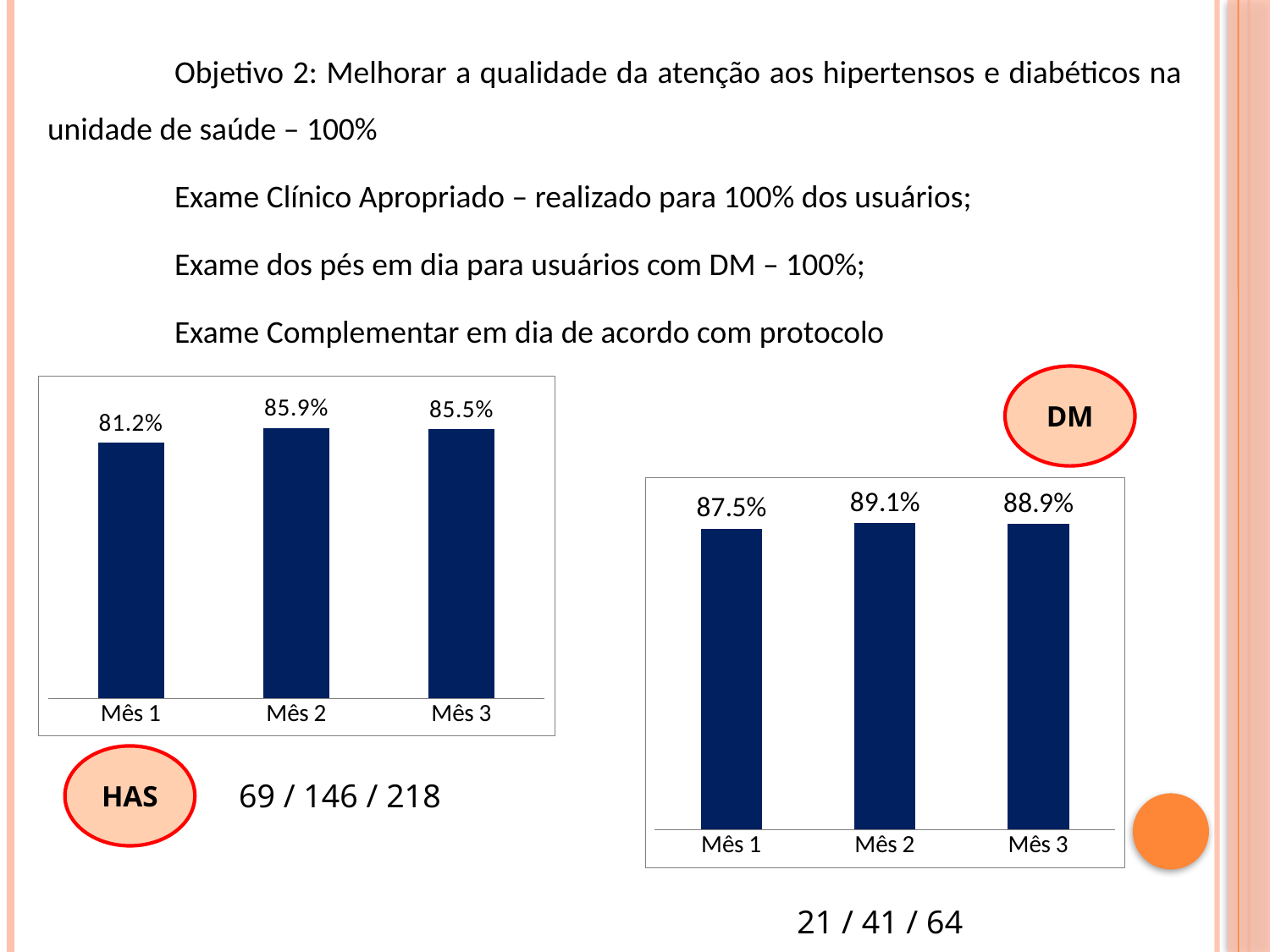
In the left chart (HAS), does the value rise or fall from Mês 1 to Mês 2? Rise In the left chart (HAS), what is the value for Mês 2? 85.9% In the right chart (DM), what is the value for Mês 3? 88.9% How many bars does the left chart (HAS) have? 3 In the left chart (HAS), what is the difference between the values for Mês 2 and Mês 1? 4.7% In the right chart (DM), what is the value for Mês 1? 87.5% In the left chart (HAS), what is the value for Mês 1? 81.2% In the right chart (DM), what is the difference between the values for Mês 2 and Mês 1? 1.6% Which is larger: the value for Mês 1 in the left chart (HAS) or the value for Mês 1 in the right chart (DM)? Mês 1 in the right chart (DM) What kind of chart is the right chart (DM)? Bar chart In the right chart (DM), which month has the highest value? Mês 2 In the left chart (HAS), which month has the lowest value? Mês 1